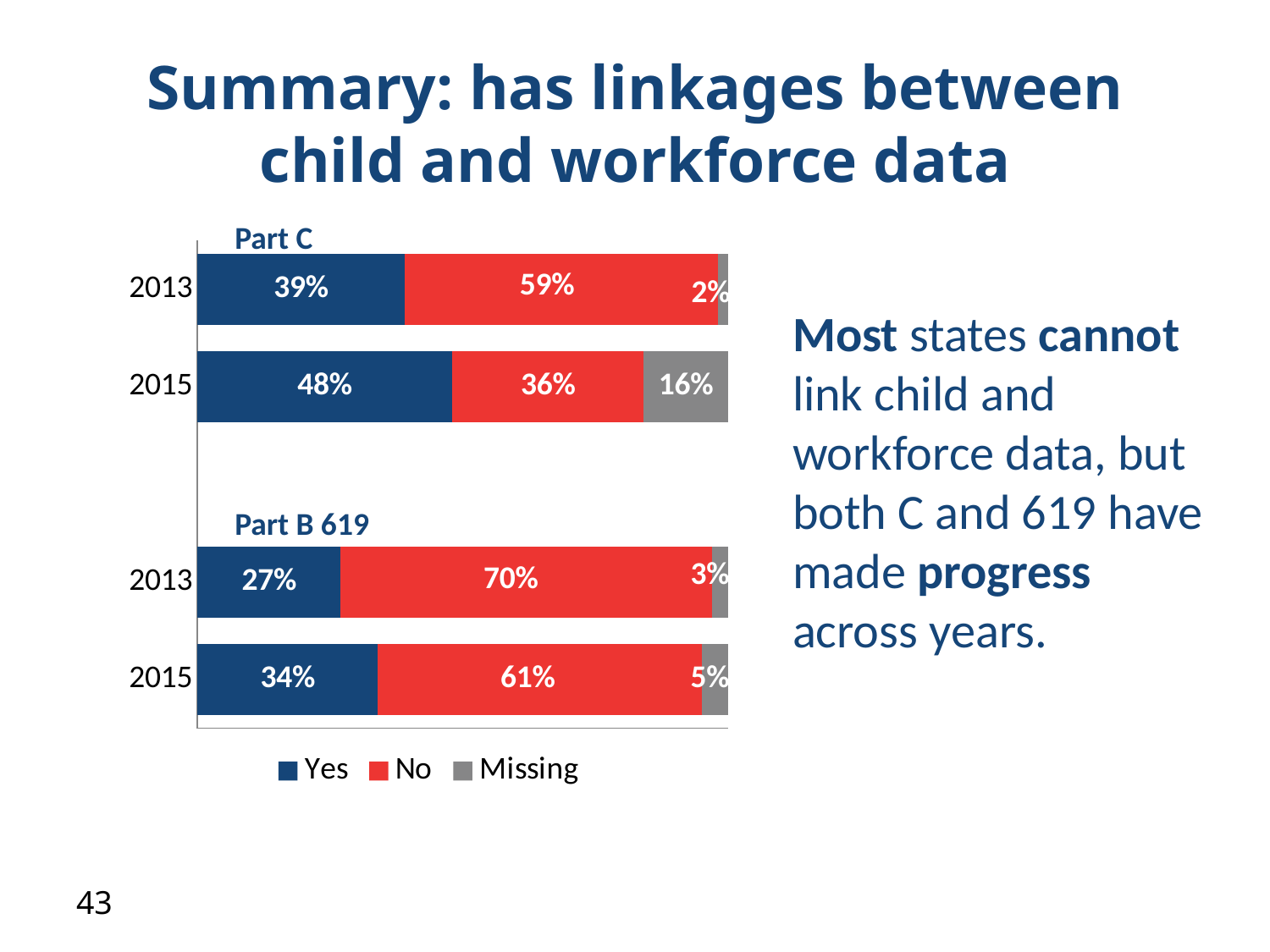
What type of chart is shown on the slide? Stacked bar chart How many series does the legend list? 3 What is the No value for Part B 619 in 2013? 70% By how many percentage points did the Yes value for Part C increase from 2013 to 2015? 9 Does the Yes percentage for Part B 619 rise or fall from 2013 to 2015? Rise What colour represents the Missing series in the chart? Grey What is the Missing value for Part C in 2015? 16% Which bar has the lowest Yes percentage? Part B 619 2013 What is the Yes value for Part B 619 in 2015? 34% Which bar has the highest Yes percentage? Part C 2015 What percentage of states answered Yes for Part C in 2015? 48% Is the No value larger for Part C 2013 or Part B 619 2013? Part B 619 2013